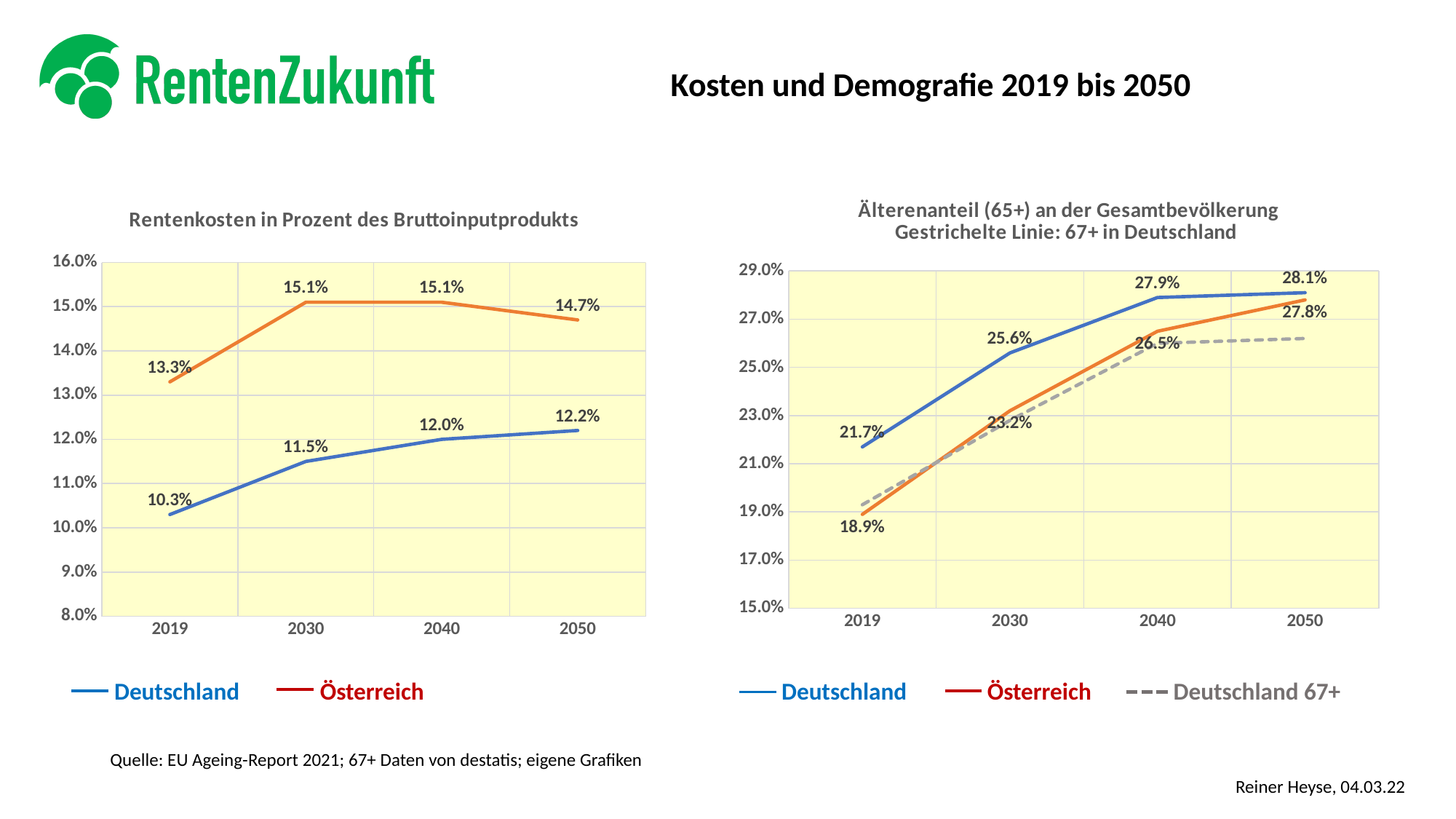
In the chart 'Rentenkosten in Prozent des Bruttoinputprodukts', how many series does the legend list? 2 In the chart 'Rentenkosten in Prozent des Bruttoinputprodukts', what is the difference between Österreich and Deutschland in 2030? 3.6% In the chart 'Rentenkosten in Prozent des Bruttoinputprodukts', what is the value for Deutschland in 2019? 10.3% What kind of chart is 'Älterenanteil (65+) an der Gesamtbevölkerung'? line chart In the chart 'Rentenkosten in Prozent des Bruttoinputprodukts', which series has the higher value in 2040, Deutschland or Österreich? Österreich In the chart 'Älterenanteil (65+) an der Gesamtbevölkerung', how many series does the legend list? 3 In the chart 'Älterenanteil (65+) an der Gesamtbevölkerung', does the Österreich line rise or fall from 2019 to 2050? rise In the chart 'Älterenanteil (65+) an der Gesamtbevölkerung', what is the value for Deutschland in 2040? 27.9% In the chart 'Rentenkosten in Prozent des Bruttoinputprodukts', what is the value for Österreich in 2050? 14.7% In the chart 'Älterenanteil (65+) an der Gesamtbevölkerung', what is the value for Österreich in 2019? 18.9% In the chart 'Älterenanteil (65+) an der Gesamtbevölkerung', is the value of the Deutschland 67+ line in 2050 greater or less than 27.0%? less In the chart 'Rentenkosten in Prozent des Bruttoinputprodukts', in which year does Deutschland reach its highest value? 2050